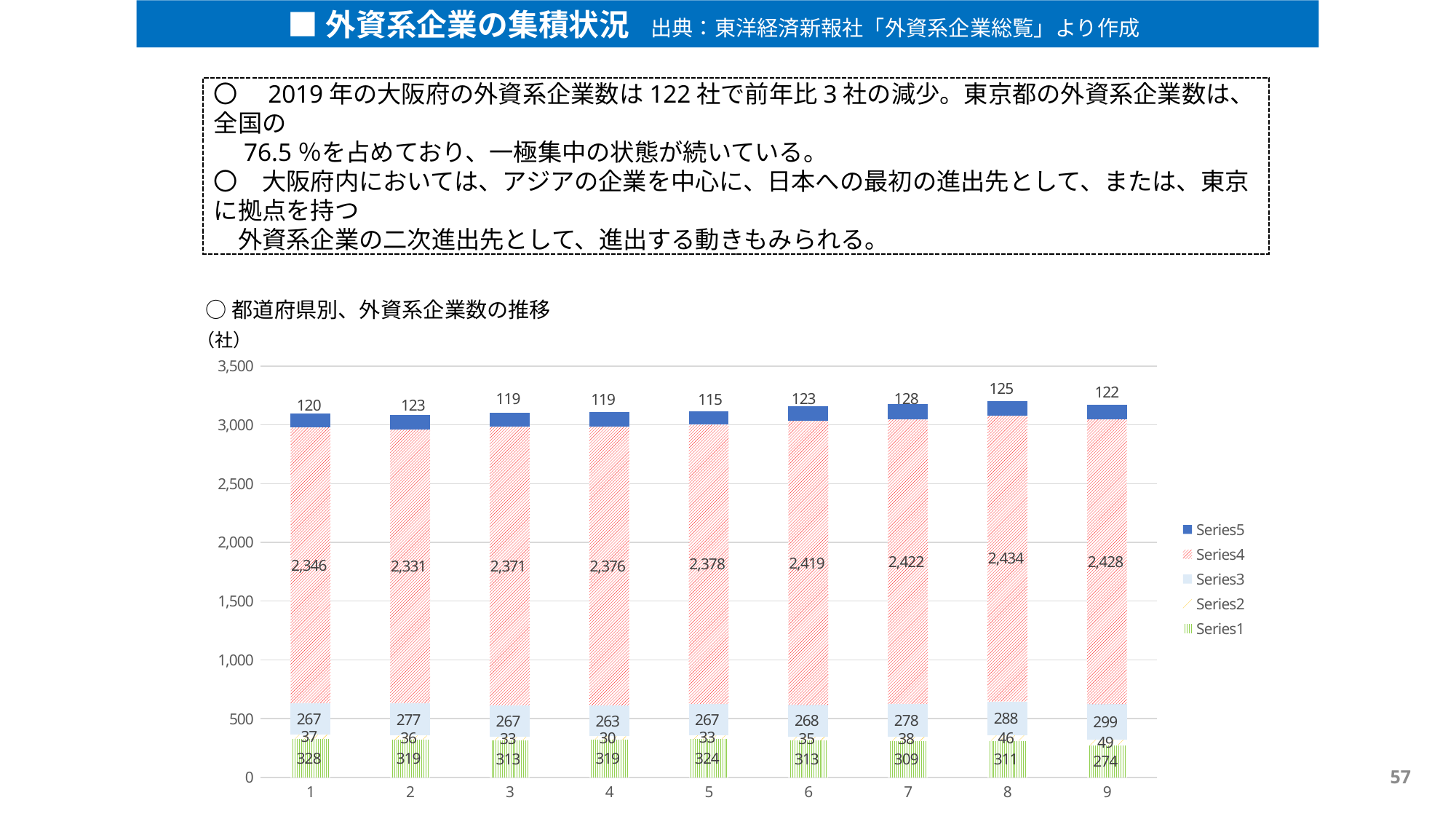
What is the total of the stacked bar for category 9? 3,172 Which is larger, the Series1 value for category 1 or for category 9? Category 1 What is the difference between the Series3 values for category 9 and category 1? 32 Which category has the highest value for Series4? 8 Is the total of the stacked bar for category 1 greater or less than 3,000? greater How many categories are shown on the x axis? 9 Which category has the lowest value for Series5? 5 What is the value of Series4 for category 8? 2,434 What is the value of Series1 for category 9? 274 What is the value of Series5 for category 7? 128 How many series does the legend list? 5 What kind of chart is shown on the slide? Stacked bar chart